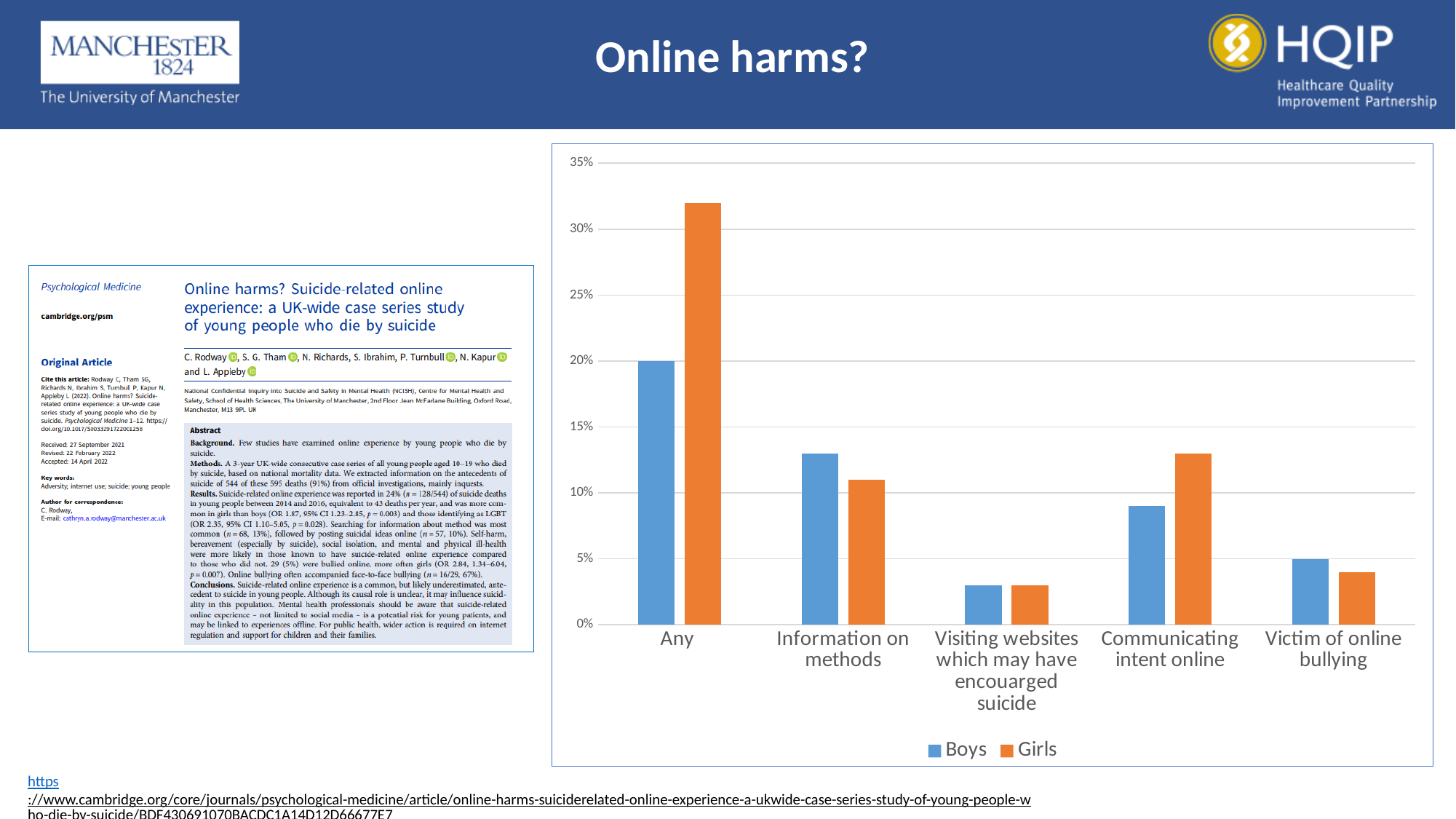
Is the Girls value for 'Any' greater or less than 30%? greater Which category has the highest bar in the chart? Any How many series does the chart legend list? 2 Which colour represents the Girls series in the chart? orange For the 'Any' category, which is larger, Boys or Girls? Girls Is the Girls value for 'Victim of online bullying' greater or less than 5%? less Which series has the tallest bar overall in the chart? Girls What kind of chart is shown on the slide? bar chart For 'Information on methods', which is larger, Boys or Girls? Boys Is the Boys value for 'Any' greater or less than 15%? greater For 'Communicating intent online', which is larger, Boys or Girls? Girls How many categories are shown on the x axis of the chart? 5